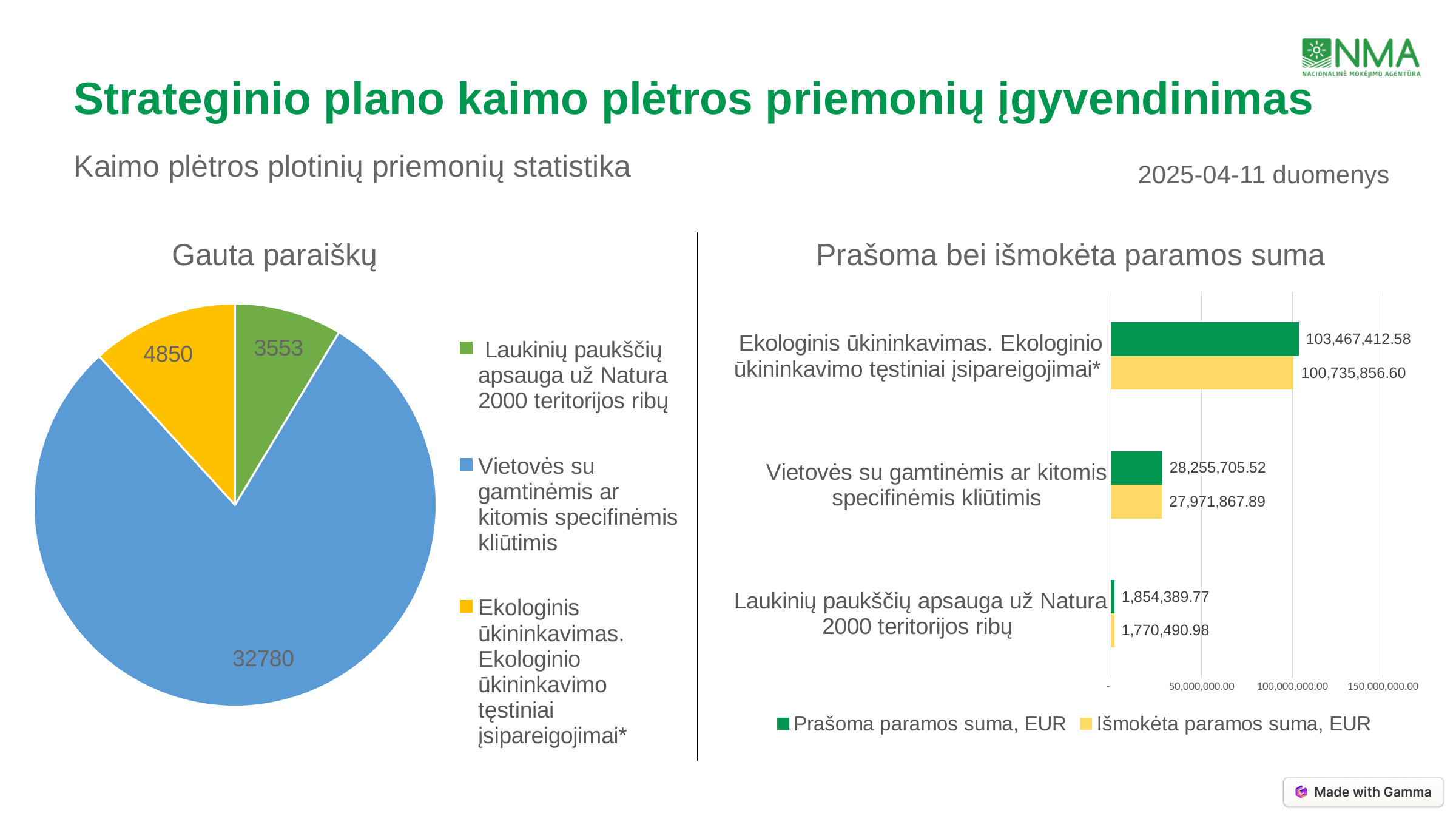
What type of chart is 'Prašoma bei išmokėta paramos suma'? Bar chart What type of chart is 'Gauta paraiškų'? Pie chart In the 'Gauta paraiškų' chart, what is the difference between the values for 'Ekologinis ūkininkavimas' and 'Laukinių paukščių apsauga už Natura 2000 teritorijos ribų'? 1297 In the 'Gauta paraiškų' chart, what is the value for 'Laukinių paukščių apsauga už Natura 2000 teritorijos ribų'? 3553 In the 'Gauta paraiškų' chart, which category has the smallest slice? Laukinių paukščių apsauga už Natura 2000 teritorijos ribų In the 'Prašoma bei išmokėta paramos suma' chart, what is the 'Išmokėta paramos suma, EUR' for 'Vietovės su gamtinėmis ar kitomis specifinėmis kliūtimis'? 27,971,867.89 How many series does the legend of the 'Prašoma bei išmokėta paramos suma' chart list? 2 In the 'Prašoma bei išmokėta paramos suma' chart, what is the 'Prašoma paramos suma, EUR' for 'Ekologinis ūkininkavimas. Ekologinio ūkininkavimo tęstiniai įsipareigojimai*'? 103,467,412.58 In the 'Gauta paraiškų' chart, how many applications were received for 'Vietovės su gamtinėmis ar kitomis specifinėmis kliūtimis'? 32780 In the 'Prašoma bei išmokėta paramos suma' chart, which category has the highest 'Prašoma paramos suma, EUR'? Ekologinis ūkininkavimas. Ekologinio ūkininkavimo tęstiniai įsipareigojimai* In the 'Gauta paraiškų' chart, how many categories are shown? 3 In the 'Prašoma bei išmokėta paramos suma' chart, what is the difference between the requested and paid amounts for 'Laukinių paukščių apsauga už Natura 2000 teritorijos ribų'? 83,898.79